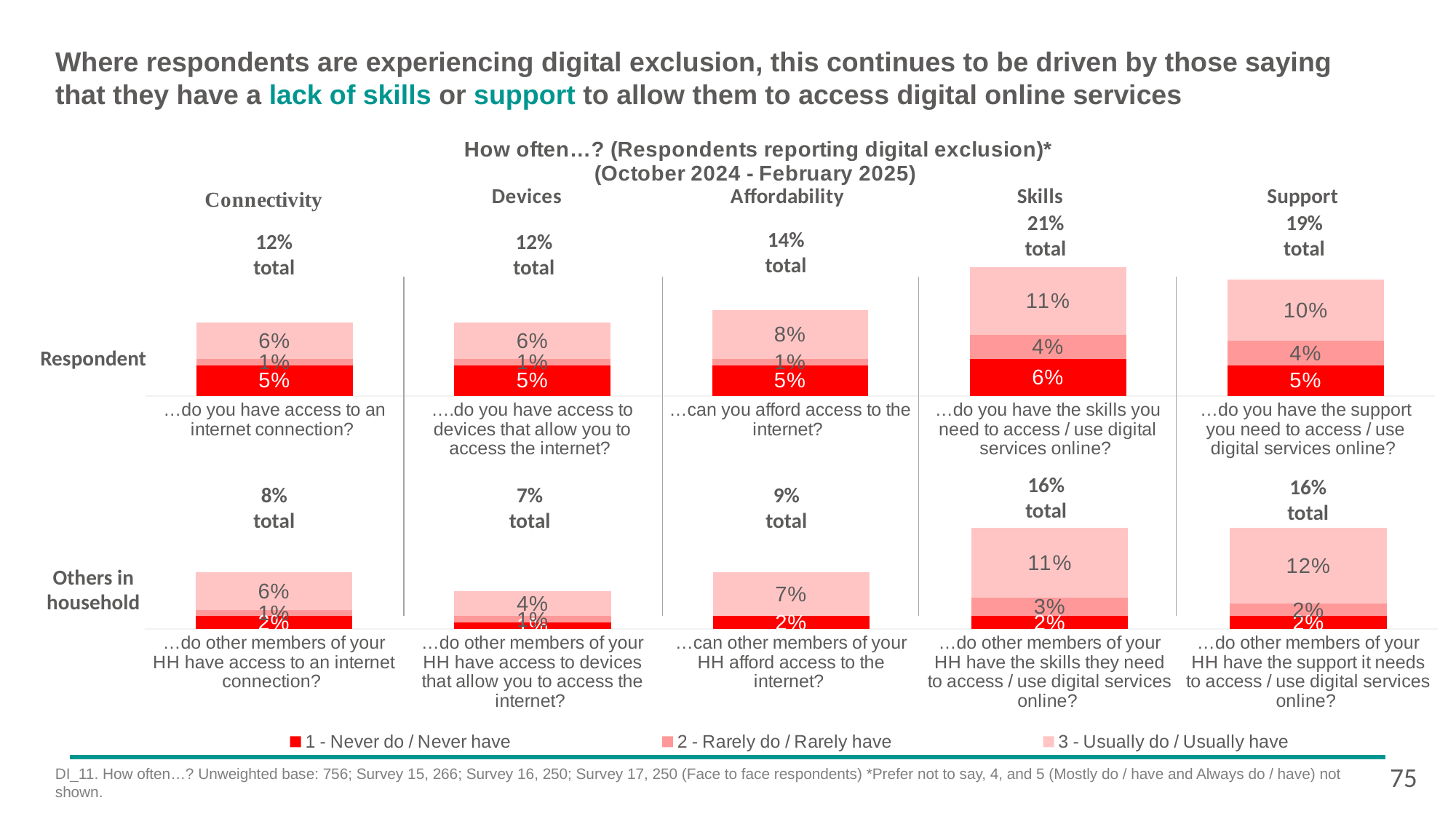
In the Respondent row, which category has the highest total? Skills How many series does the legend list? 3 In the Respondent row, what is the value of the '1 - Never do / Never have' segment for Affordability? 5% Which legend entry is shown in the darkest red colour? 1 - Never do / Never have In the Respondent row, what is the value of the '3 - Usually do / Usually have' segment for Support? 10% What kind of chart is used on this slide? Stacked bar chart In the Others in household row, which has the larger total: Skills or Devices? Skills In the Others in household row, what is the value of the '3 - Usually do / Usually have' segment for Support? 12% In the Respondent row, what is the total shown for Skills? 21% In the Others in household row, what is the total shown for Connectivity? 8% In the Respondent row, what is the difference between the Skills total and the Connectivity total? 9 percentage points In the Others in household row, which category has the lowest total? Devices